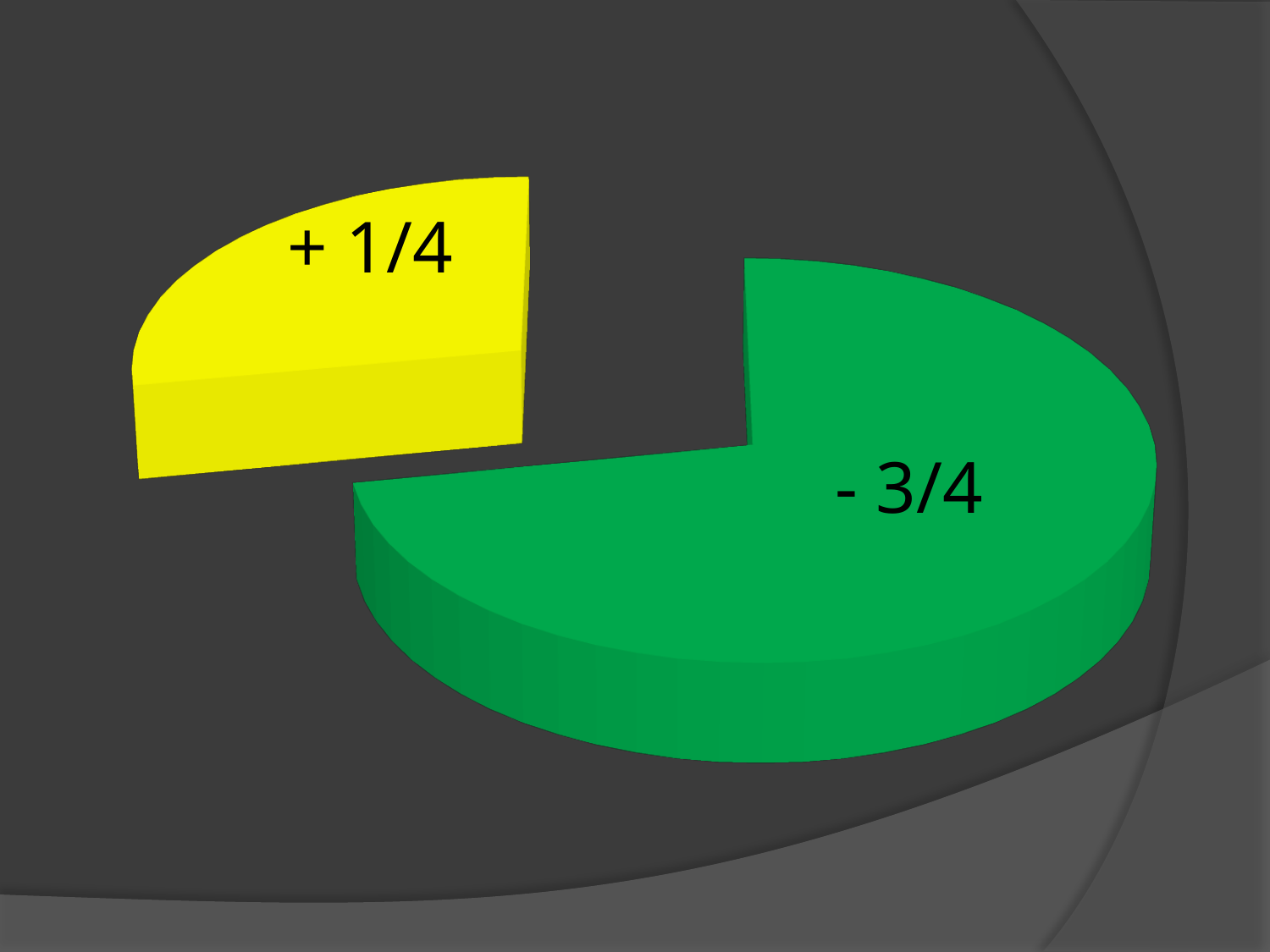
What label is printed on the yellow slice of the pie chart? + 1/4 What colour is the slice labelled "+ 1/4"? yellow Which slice of the pie chart is the largest? the green slice (- 3/4) Which slice of the pie chart is the smallest? the yellow slice (+ 1/4) Which slice of the pie chart is larger, the yellow one or the green one? the green one How many slices does the pie chart have? 2 What kind of chart is shown on the slide? pie chart Which slice is pulled out (exploded) from the rest of the pie chart? the yellow slice (+ 1/4) What label is printed on the green slice of the pie chart? - 3/4